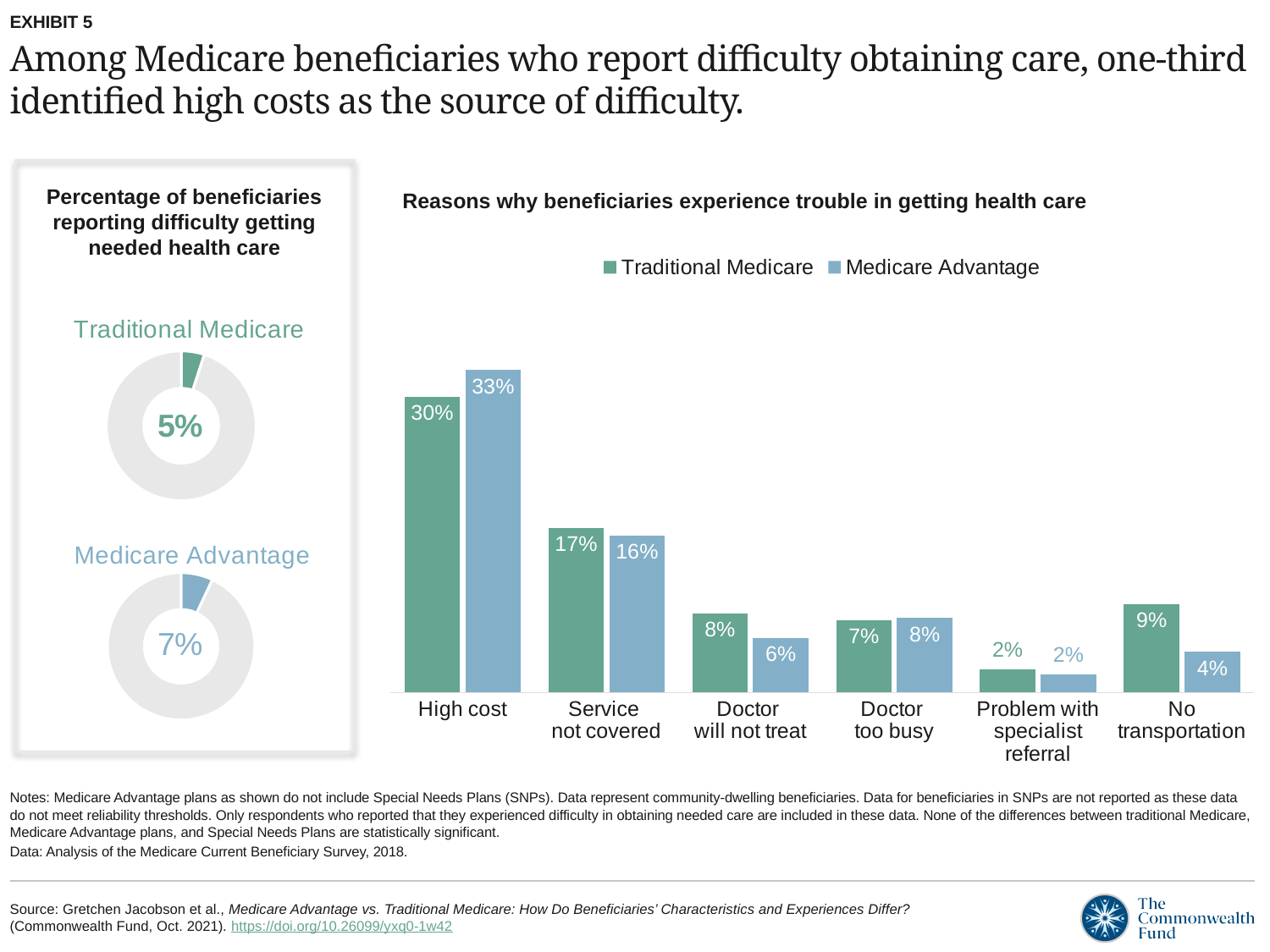
In the 'Reasons why beneficiaries experience trouble in getting health care' chart, what is the Traditional Medicare value for Service not covered? 17% How many series does the legend list in the 'Reasons why beneficiaries experience trouble in getting health care' chart? 2 In the 'Reasons why beneficiaries experience trouble in getting health care' chart, what is the difference between the Traditional Medicare and Medicare Advantage values for Doctor will not treat? 2% In the 'Reasons why beneficiaries experience trouble in getting health care' chart, what is the Medicare Advantage value for High cost? 33% How many reasons (categories) are shown in the 'Reasons why beneficiaries experience trouble in getting health care' chart? 6 What kind of chart is the 'Reasons why beneficiaries experience trouble in getting health care' chart? Bar chart In the 'Percentage of beneficiaries reporting difficulty getting needed health care' donut charts, what is the value for Medicare Advantage? 7% In the 'Percentage of beneficiaries reporting difficulty getting needed health care' donut charts, what is the value for Traditional Medicare? 5% In the 'Reasons why beneficiaries experience trouble in getting health care' chart, what is the difference between the Medicare Advantage and Traditional Medicare values for High cost? 3% In the 'Reasons why beneficiaries experience trouble in getting health care' chart, which is larger for No transportation: Traditional Medicare or Medicare Advantage? Traditional Medicare In the 'Reasons why beneficiaries experience trouble in getting health care' chart, which reason has the highest Traditional Medicare value? High cost In the 'Reasons why beneficiaries experience trouble in getting health care' chart, which reason has the lowest Medicare Advantage value? Problem with specialist referral